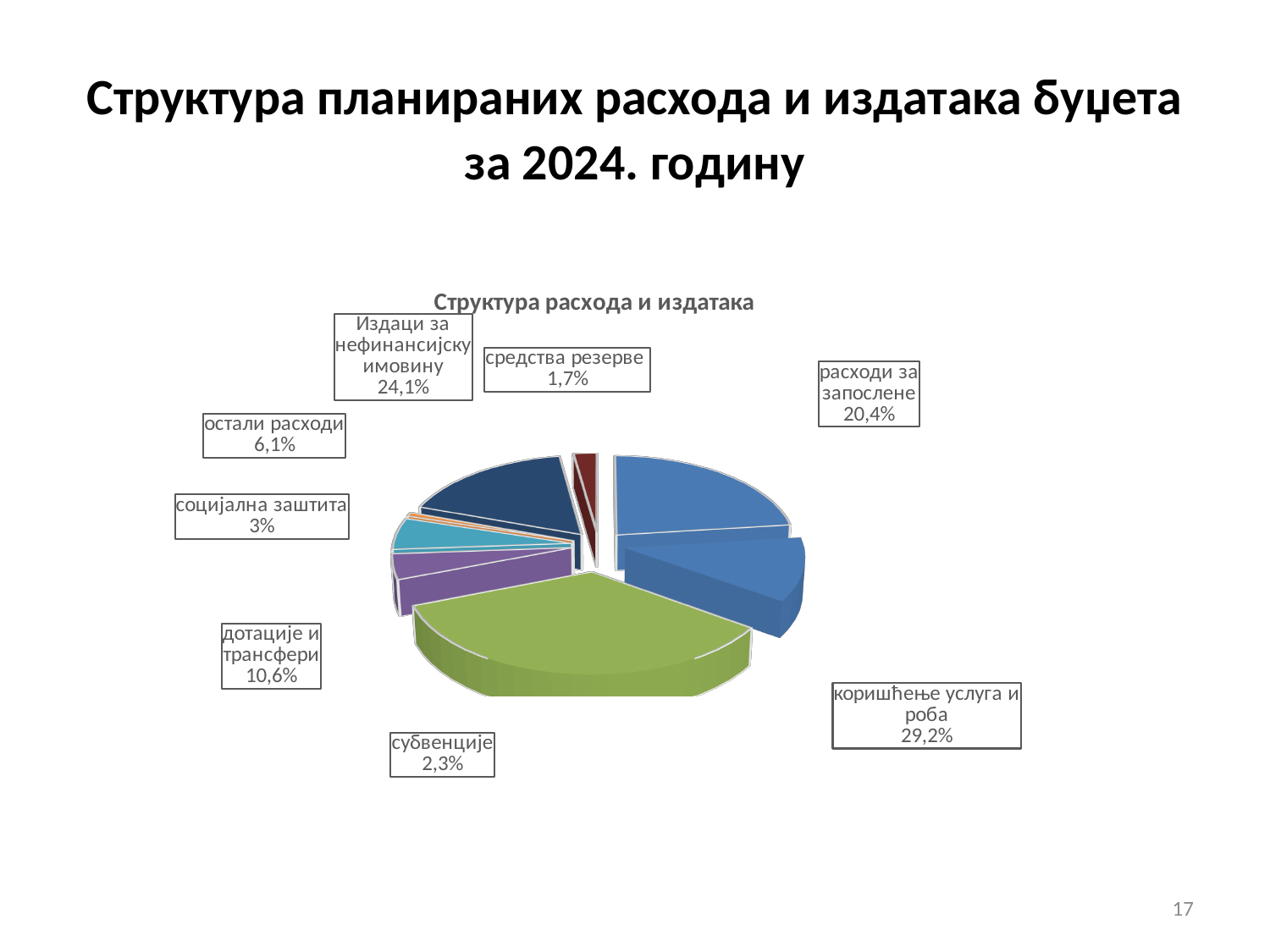
What percentage is shown for дотације и трансфери? 10,6% What is the title of the chart? Структура расхода и издатака Which category has the largest share of the pie? коришћење услуга и роба What share of the pie is labelled for коришћење услуга и роба? 29,2% How many categories (slices) does the pie chart have? 8 What kind of chart is shown on the slide? pie chart Which category has the smallest share of the pie? средства резерве What percentage is shown for Издаци за нефинансијску имовину? 24,1% What is the difference in percentage points between коришћење услуга и роба and расходи за запослене? 8,8 What percentage is shown for средства резерве? 1,7% What percentage is shown for расходи за запослене? 20,4% Which is larger, the share for остали расходи or the share for социјална заштита? остали расходи